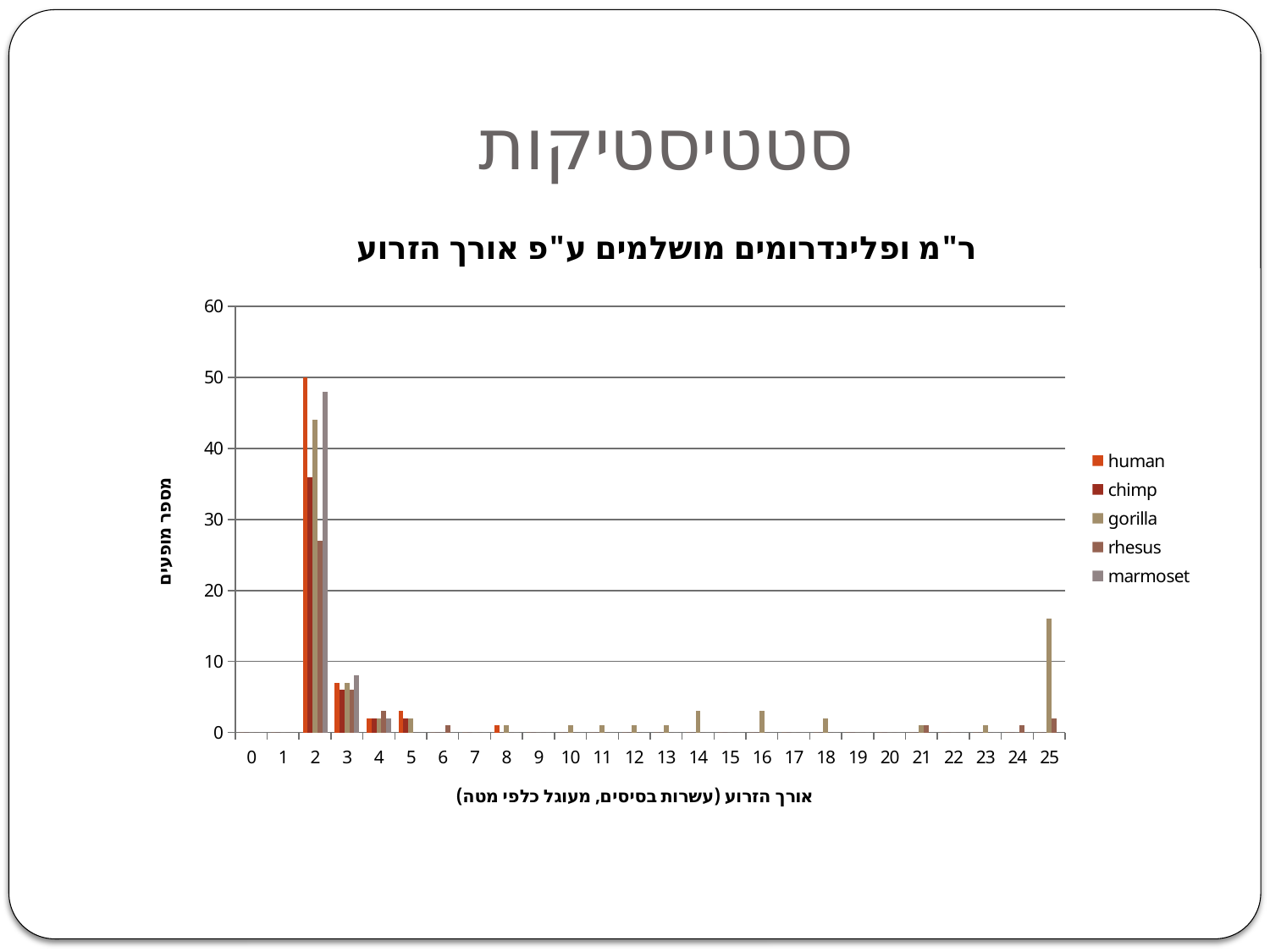
Is the value for human at x = 2 greater or less than 40? greater Is the value for rhesus at x = 2 greater or less than 20? greater How many categories are shown on the x axis? 26 At x = 25, which is larger, the gorilla bar or the rhesus bar? gorilla How many series does the legend list? 5 At x = 2, which is larger, the human bar or the rhesus bar? human Is the value for chimp at x = 2 greater or less than 30? greater Which series has the tallest bar at x = 2? human What kind of chart is shown on the slide? bar chart Which series are listed in the legend? human, chimp, gorilla, rhesus, marmoset